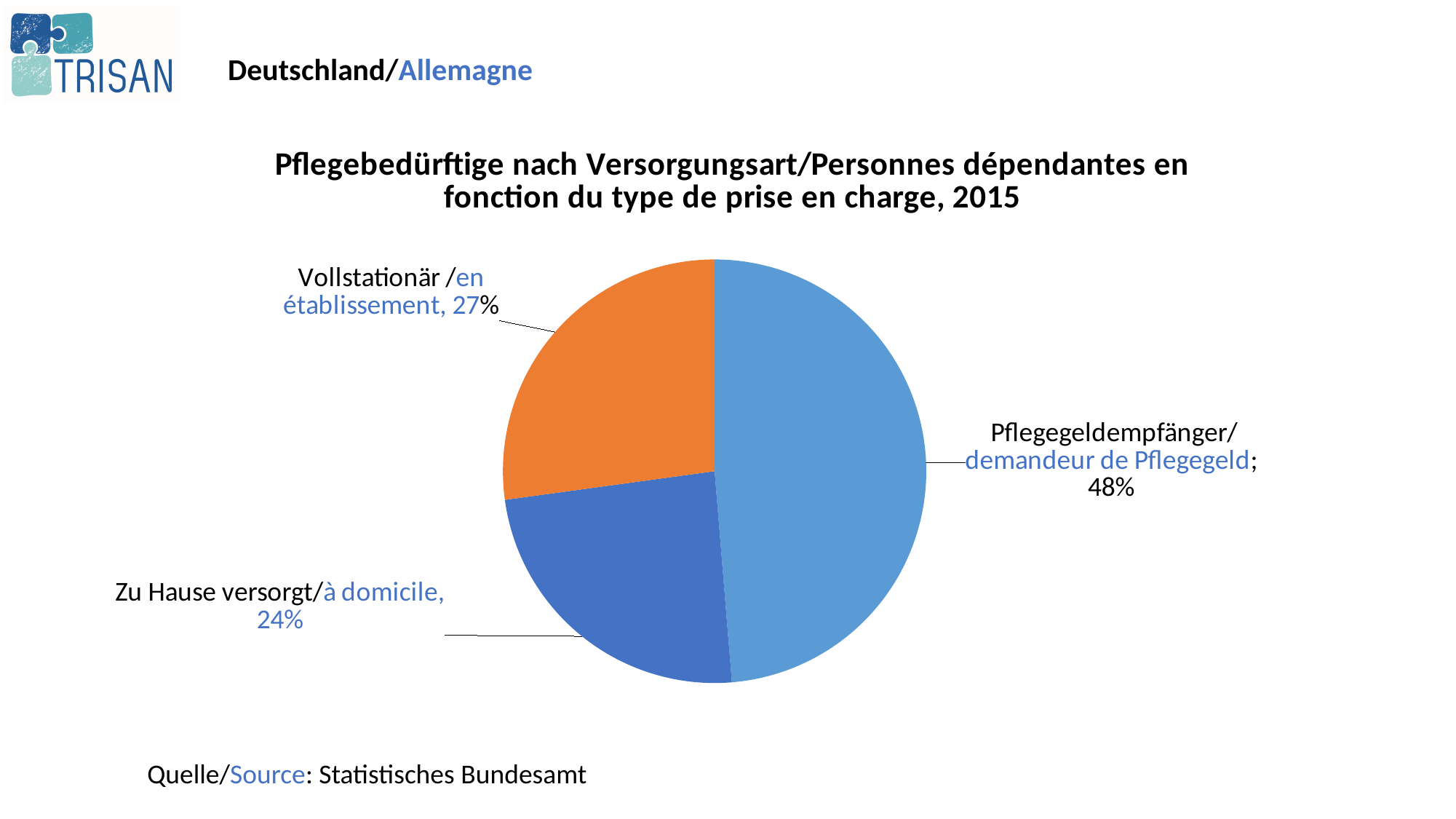
Which is larger, the share for Vollstationär/en établissement or the share for Zu Hause versorgt/à domicile? Vollstationär/en établissement What year does the chart title refer to? 2015 How many slices does the pie chart have? 3 Which category has the smallest share of the pie? Zu Hause versorgt/à domicile What share of the pie is labelled Vollstationär/en établissement? 27% What share of the pie is labelled Pflegegeldempfänger/demandeur de Pflegegeld? 48% What colour is the slice for Vollstationär/en établissement? Orange What kind of chart is shown on the slide? Pie chart What is the difference in percentage points between the Vollstationär share and the Zu Hause versorgt share? 3 Which category has the largest share of the pie? Pflegegeldempfänger/demandeur de Pflegegeld What share of the pie is labelled Zu Hause versorgt/à domicile? 24% What is the difference in percentage points between the Pflegegeldempfänger share and the Vollstationär share? 21